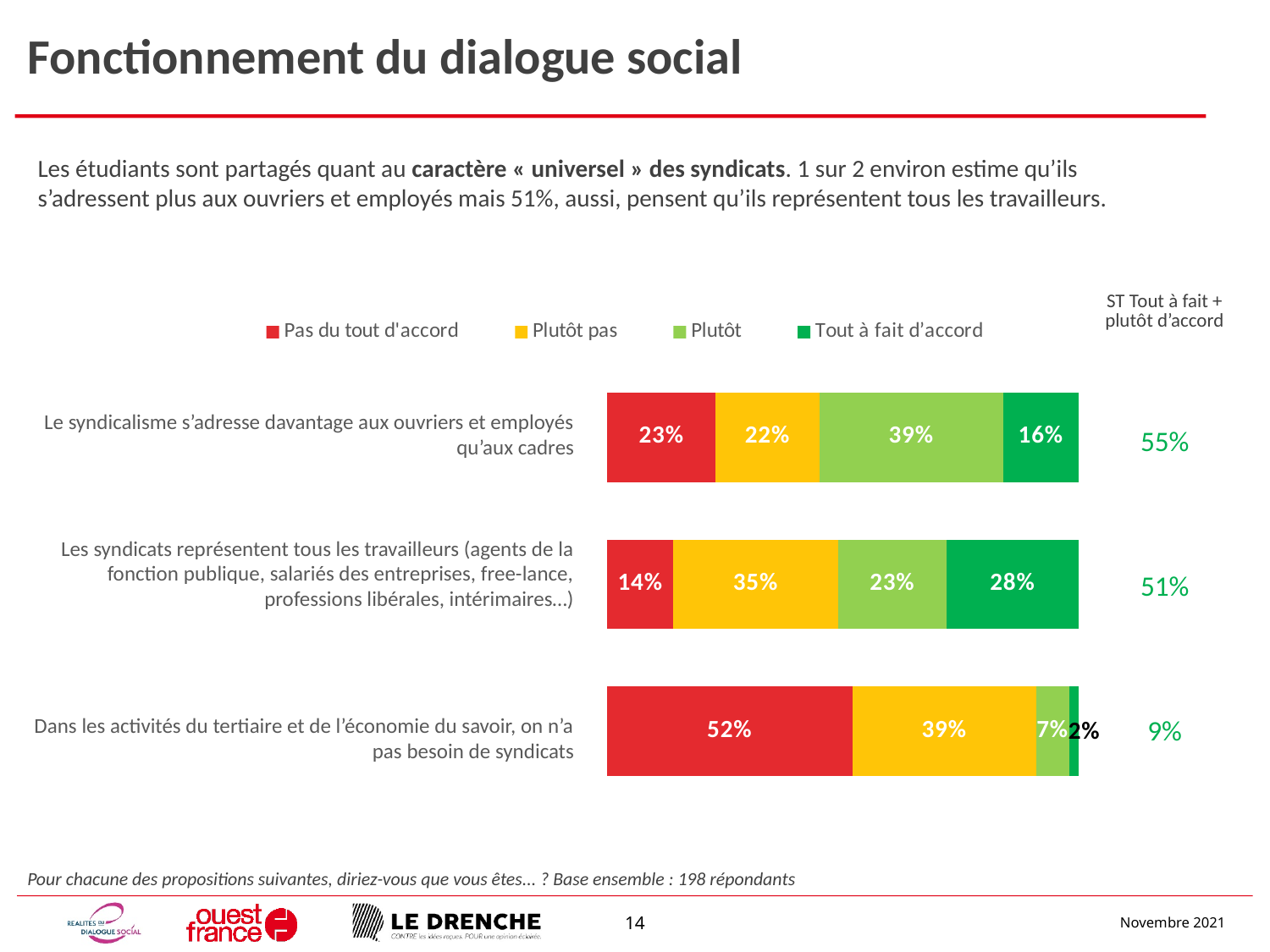
How many propositions (bars) are shown in the chart? 3 What kind of chart is shown on the slide? Stacked bar chart Which proposition has the lowest "ST Tout à fait + plutôt d'accord" value? Dans les activités du tertiaire et de l'économie du savoir, on n'a pas besoin de syndicats What is the "ST Tout à fait + plutôt d'accord" value shown for "Le syndicalisme s'adresse davantage aux ouvriers et employés qu'aux cadres"? 55% What is the difference between the "Plutôt pas" values for "Les syndicats représentent tous les travailleurs…" (35%) and "Le syndicalisme s'adresse davantage aux ouvriers et employés qu'aux cadres" (22%)? 13 percentage points What is the "Plutôt" value for "Le syndicalisme s'adresse davantage aux ouvriers et employés qu'aux cadres"? 39% What is the total of the "Plutôt" and "Tout à fait d'accord" segments for "Dans les activités du tertiaire et de l'économie du savoir, on n'a pas besoin de syndicats"? 9% Which proposition has the highest "Pas du tout d'accord" share? Dans les activités du tertiaire et de l'économie du savoir, on n'a pas besoin de syndicats What is the "Tout à fait d'accord" value for "Les syndicats représentent tous les travailleurs (agents de la fonction publique, salariés des entreprises, free-lance, professions libérales, intérimaires…)"? 28% What percentage of respondents answered "Pas du tout d'accord" to "Dans les activités du tertiaire et de l'économie du savoir, on n'a pas besoin de syndicats"? 52% For "Les syndicats représentent tous les travailleurs…", which is larger: the "Plutôt pas" share or the "Tout à fait d'accord" share? Plutôt pas How many series does the legend list? 4